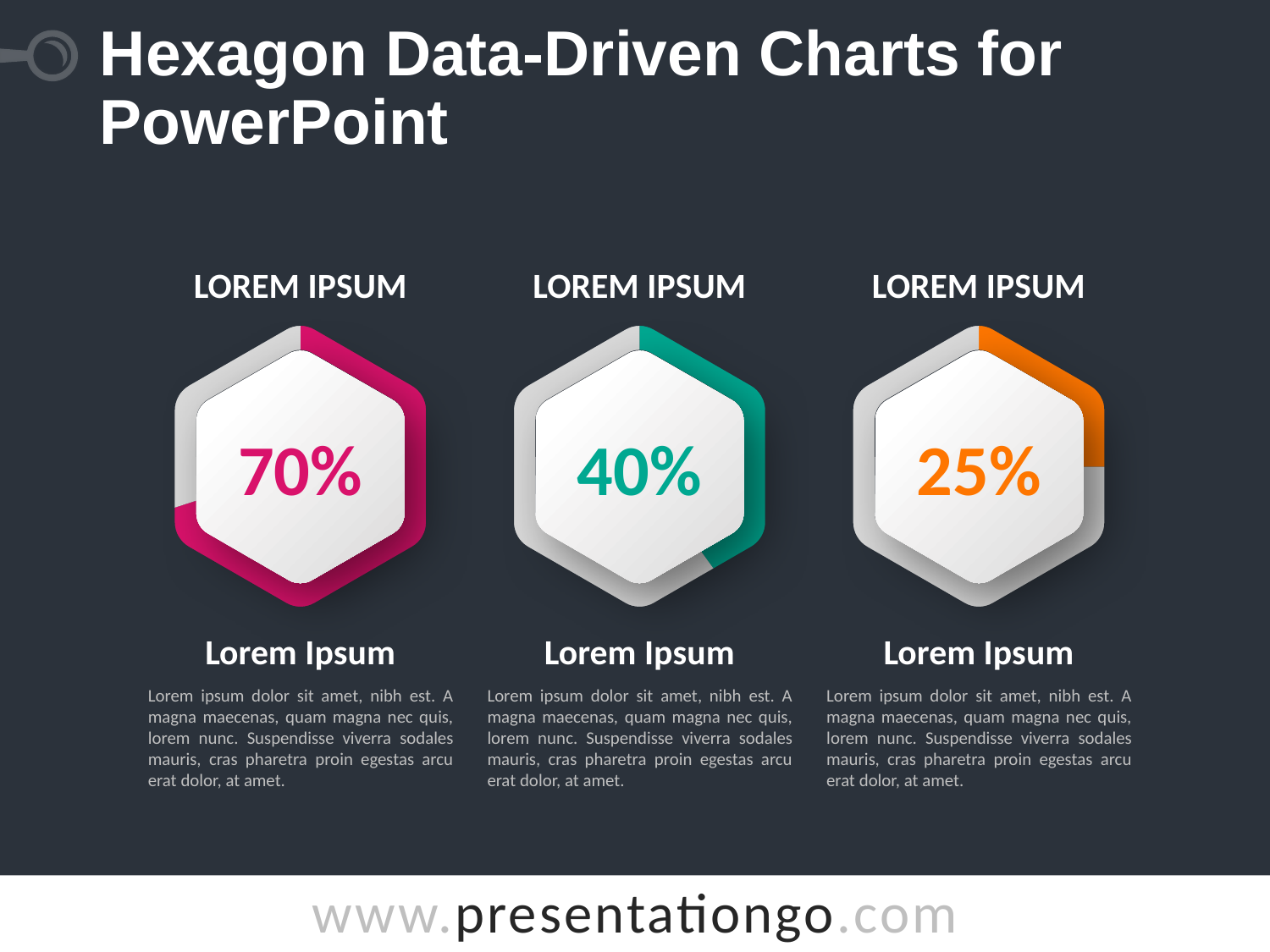
Which hexagon chart shows the highest percentage: left, middle or right? left Do the percentage values rise or fall from the left chart to the right chart? fall What colour is the filled ring of the right hexagon chart? orange Which hexagon chart shows the lowest percentage: left, middle or right? right What value is shown in the right hexagon chart? 25% What is the difference between the value in the middle hexagon chart and the value in the right hexagon chart? 15% What value is shown in the left hexagon chart? 70% What colour is the filled ring of the left hexagon chart? pink How many hexagon charts are on the slide? 3 Which is larger, the value in the middle hexagon chart or the value in the right hexagon chart? middle What value is shown in the middle hexagon chart? 40% What is the difference between the value in the left hexagon chart and the value in the middle hexagon chart? 30%